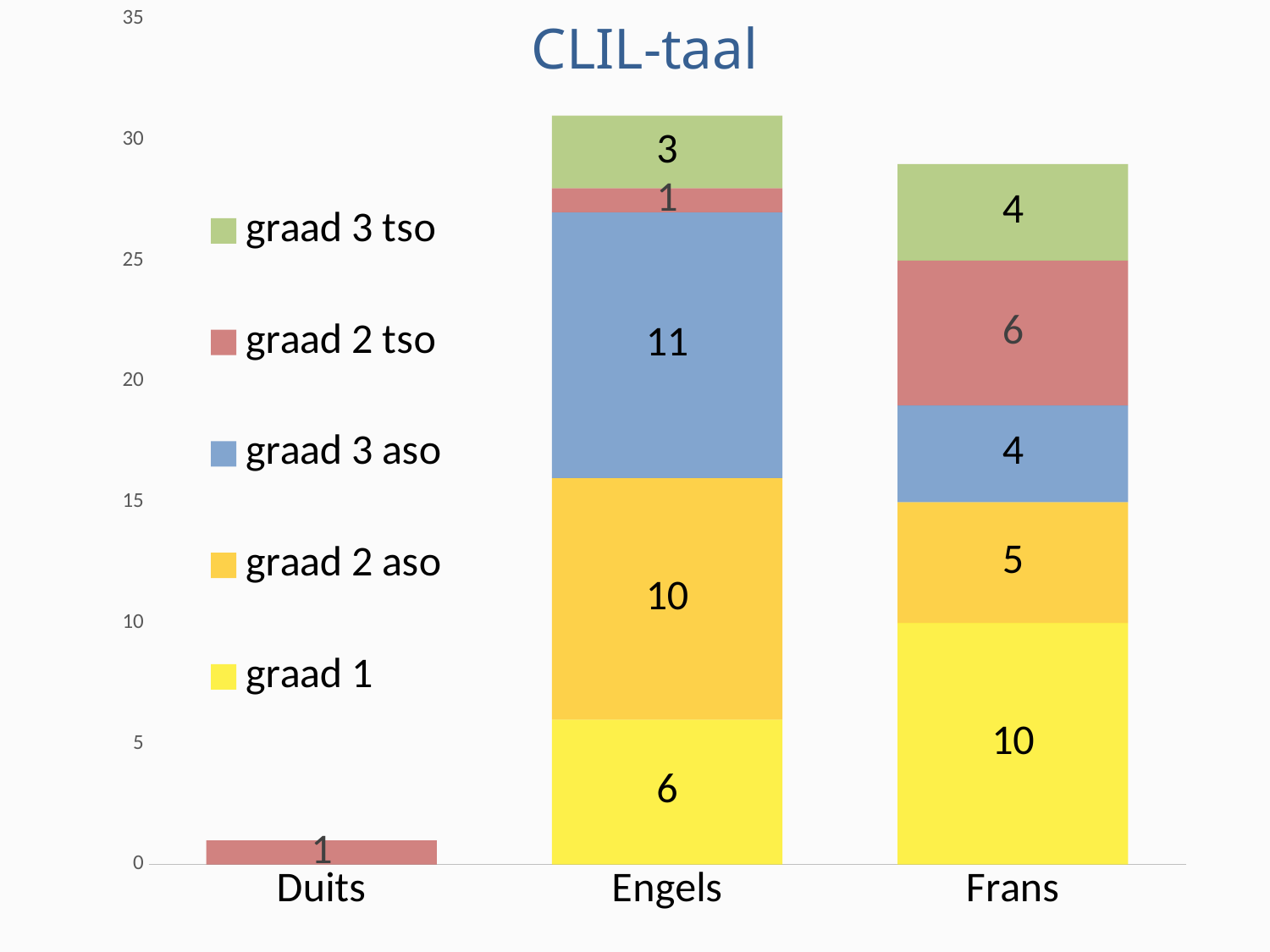
Which category has the highest total? Engels What is the title of the chart? CLIL-taal What is the difference between the graad 2 aso values for Engels and Frans? 5 What is the total of the stacked bar for Engels? 31 What is the value for graad 3 tso in the Frans bar? 4 How many series does the legend list? 5 Which is larger: graad 2 tso for Frans or graad 2 tso for Engels? Frans What is the value for graad 2 tso in the Duits bar? 1 What is the value for graad 3 aso in the Engels bar? 11 Which category has the lowest total? Duits What is the total of the stacked bar for Frans? 29 What is the value for graad 1 in the Frans bar? 10